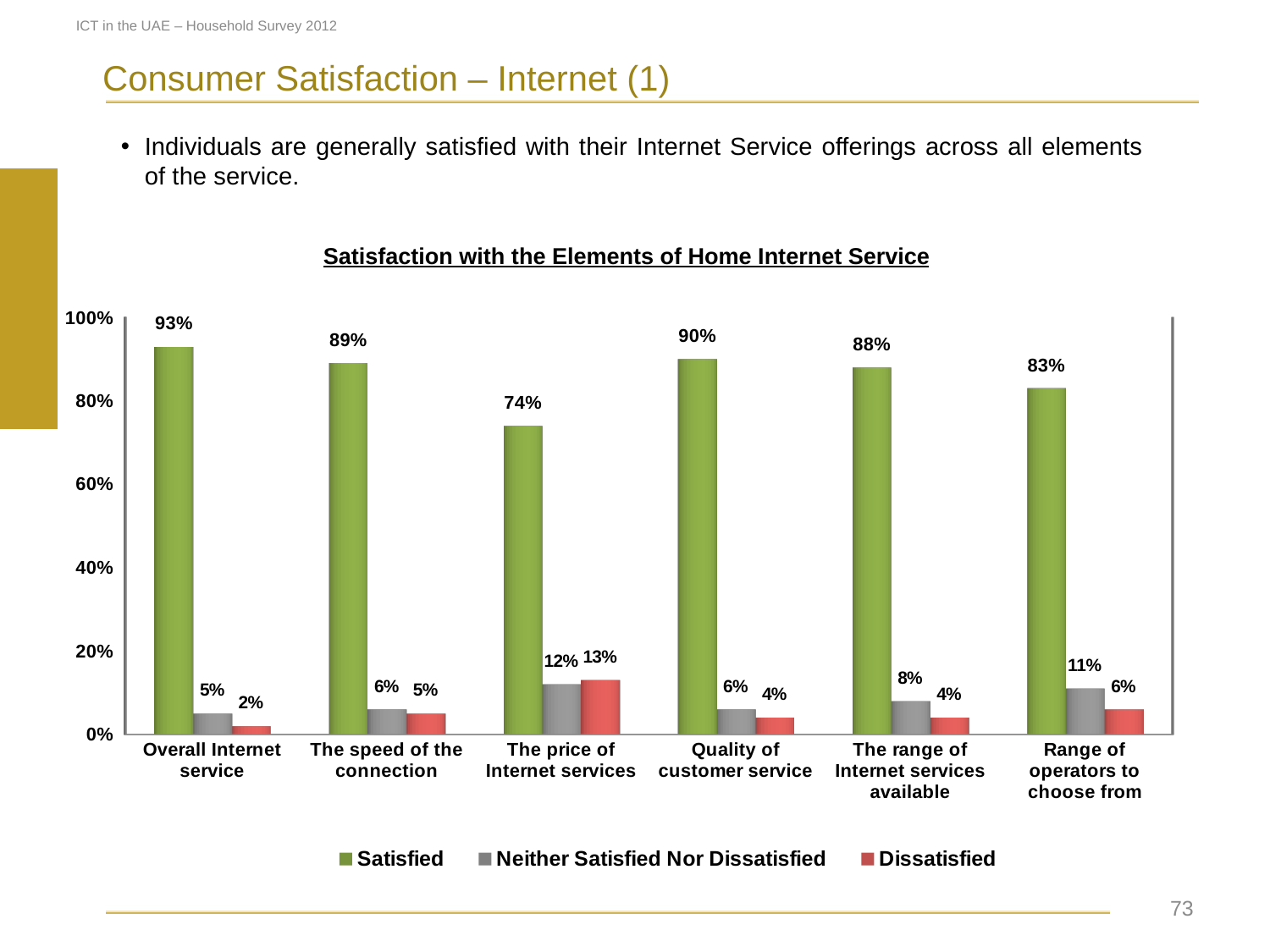
Which element has the lowest Satisfied percentage? The price of Internet services Which colour represents the Dissatisfied series in the chart? Red How many elements of home Internet service are shown on the x axis? 6 What is the difference between the Satisfied percentages for overall Internet service and the price of Internet services? 19% What kind of chart is shown on the slide? Bar chart What is the Dissatisfied value for the price of Internet services? 13% Is the Satisfied percentage higher for the speed of the connection or for quality of customer service? Quality of customer service What is the title of the chart? Satisfaction with the Elements of Home Internet Service What is the Neither Satisfied Nor Dissatisfied value for the range of operators to choose from? 11% How many series does the legend list? 3 What percentage of individuals are satisfied with the overall Internet service? 93% Which element has the highest Satisfied percentage? Overall Internet service